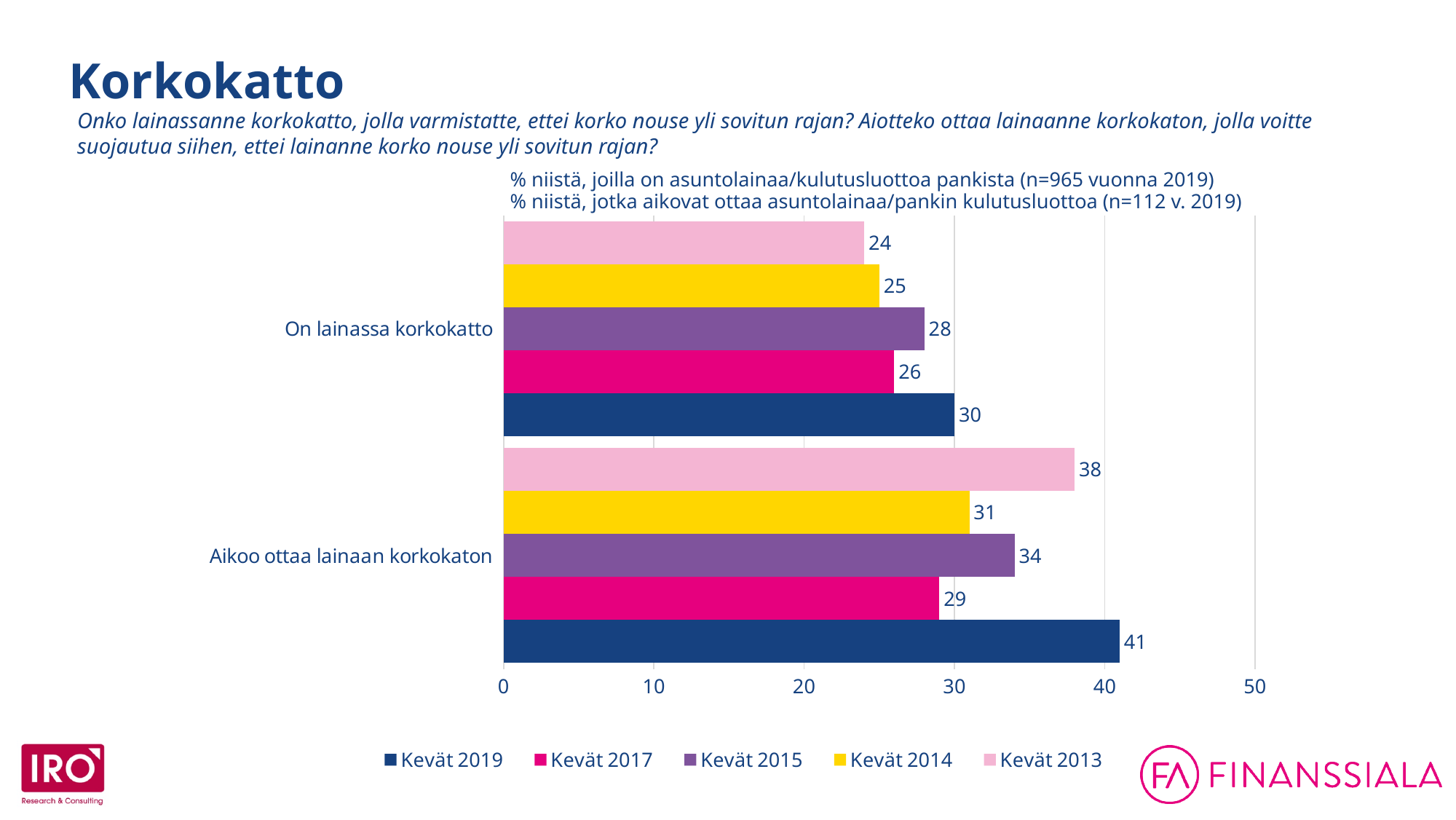
What is the difference between the Kevät 2019 values for 'Aikoo ottaa lainaan korkokaton' and 'On lainassa korkokatto'? 11 How many series does the legend list? 5 Which is larger: the Kevät 2014 value for 'On lainassa korkokatto' or the Kevät 2014 value for 'Aikoo ottaa lainaan korkokaton'? Aikoo ottaa lainaan korkokaton How many categories are shown on the chart? 2 Is the Kevät 2017 value for 'Aikoo ottaa lainaan korkokaton' greater or less than 30? less What is the value for Kevät 2019 in the 'On lainassa korkokatto' category? 30 What is the value for Kevät 2013 in the 'Aikoo ottaa lainaan korkokaton' category? 38 Which series has the lowest value in the 'On lainassa korkokatto' category? Kevät 2013 What kind of chart is shown on the slide? Bar chart What is the value for Kevät 2015 in the 'On lainassa korkokatto' category? 28 Which colour represents Kevät 2014 in the chart? Yellow Which series has the highest value in the 'Aikoo ottaa lainaan korkokaton' category? Kevät 2019